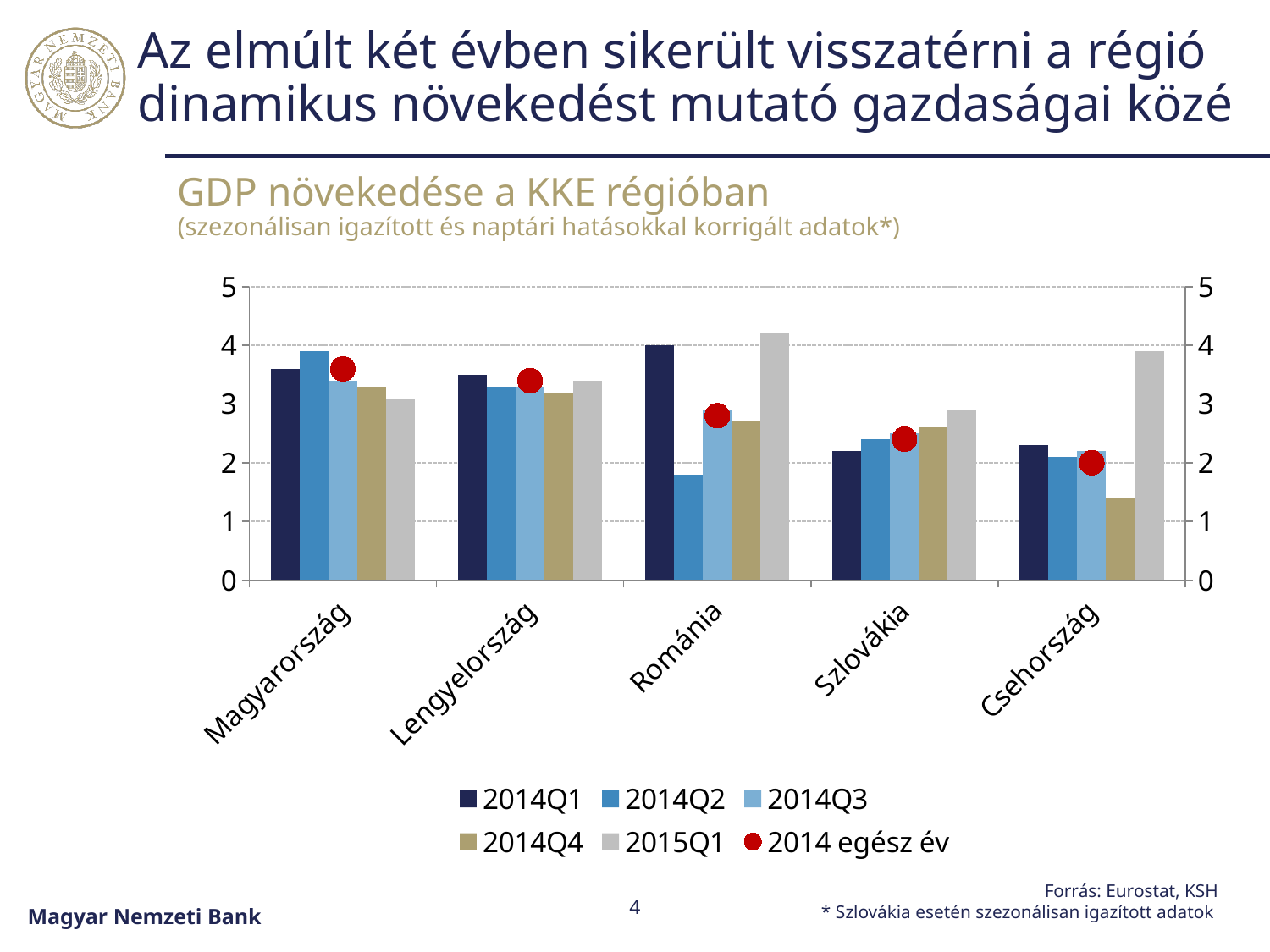
What is the title of the chart? GDP növekedése a KKE régióban Is the 2014Q4 value for Csehország greater or less than 2? less Is the 2015Q1 value for Csehország greater or less than 3? greater Is the 2014Q2 value for Románia greater or less than 2? less How many countries are shown on the x axis of the chart? 5 Which country has the lowest 2014Q4 value? Csehország What kind of chart is shown on the slide? bar chart How many series does the chart's legend list? 6 Which country has the highest 2015Q1 value? Románia For Románia, which is larger: the 2014Q1 value or the 2014Q2 value? 2014Q1